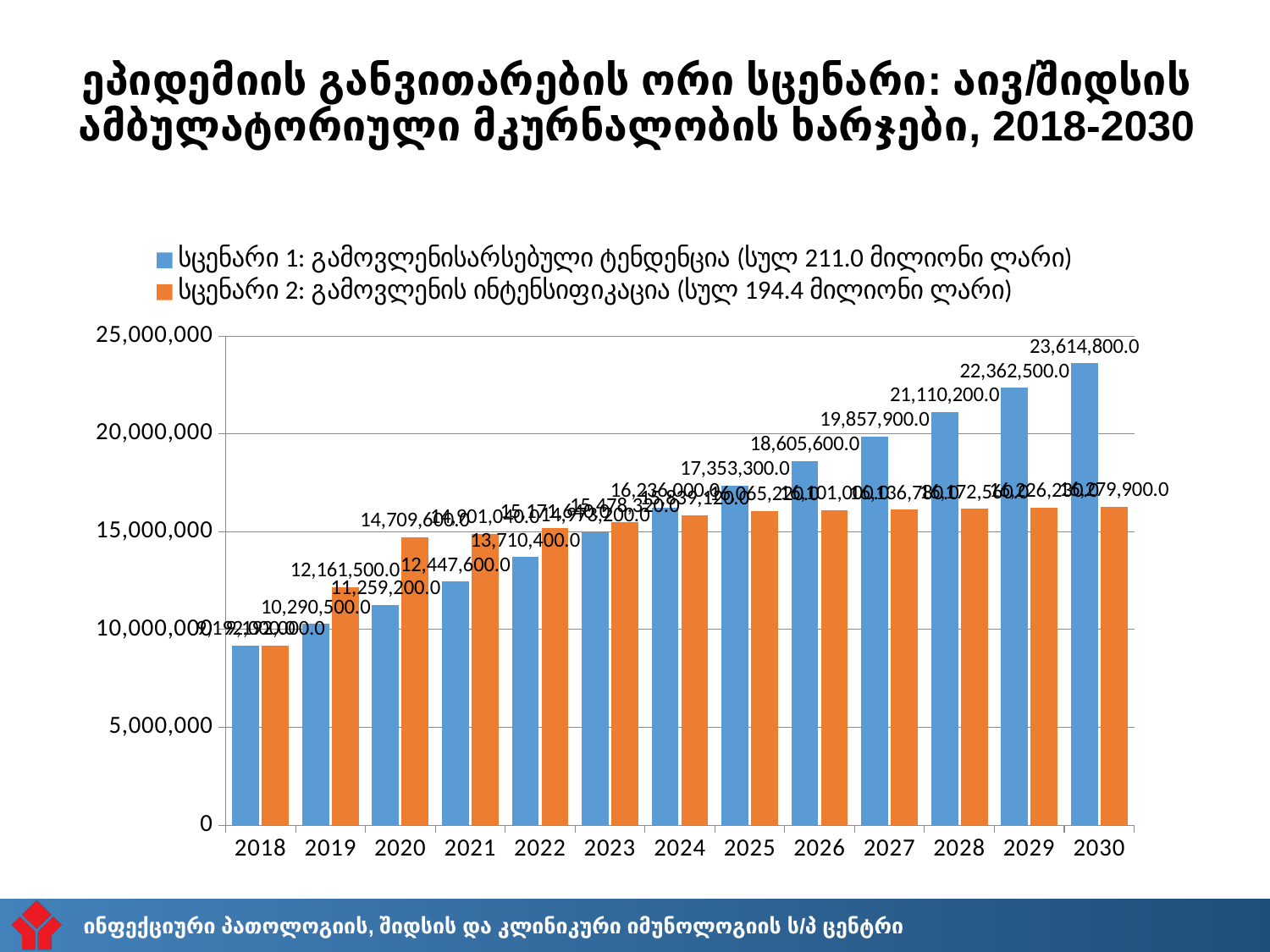
In 2019, which series has the larger value, სცენარი 1 or სცენარი 2? სცენარი 2 How many years are shown on the x axis? 13 What is the value for სცენარი 2 in 2020? 14,709,600.0 What is the difference between the სცენარი 1 values for 2030 and 2029? 1,252,300.0 What is the value for სცენარი 1 in 2030? 23,614,800.0 What type of chart is shown on the slide? bar chart In which year is the value for სცენარი 1 highest? 2030 How many series does the legend list? 2 Do the values for სცენარი 1 rise or fall from 2018 to 2030? rise What is the value for სცენარი 2 in 2019? 12,161,500.0 What is the value for სცენარი 1 in 2027? 19,857,900.0 In which year is the value for სცენარი 1 lowest? 2018